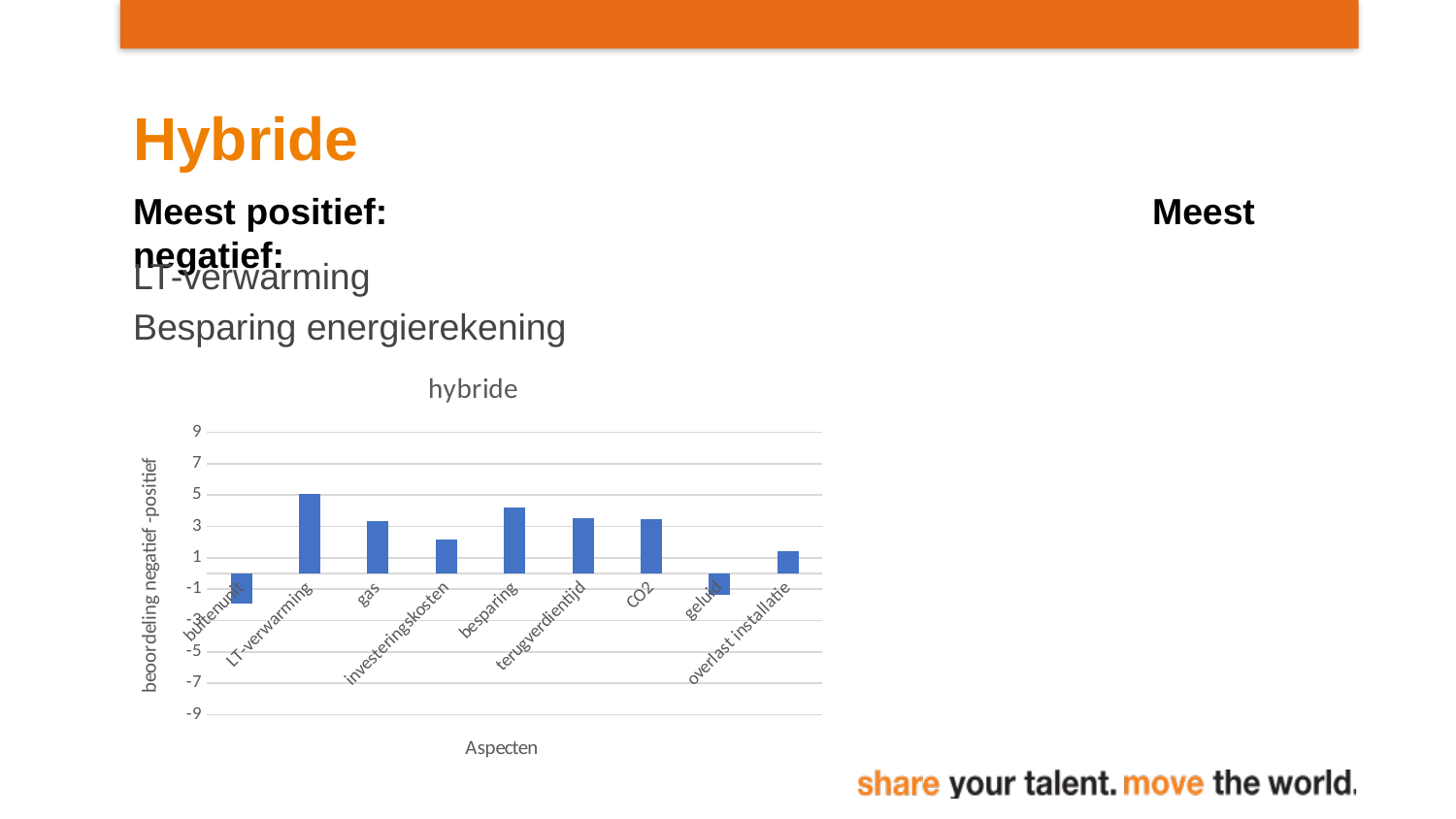
Is the value for buitenunit greater or less than 0? less Is the value for besparing greater or less than 3? greater Which category has the highest value in the chart? LT-verwarming What kind of chart is shown on the slide? bar chart What is the label of the x axis? Aspecten Is the value for overlast installatie greater or less than 3? less What is the title of the chart? hybride How many categories (aspecten) are plotted in the chart? 9 Which is larger, the value for LT-verwarming or the value for gas? LT-verwarming How many categories have a negative value in the chart? 2